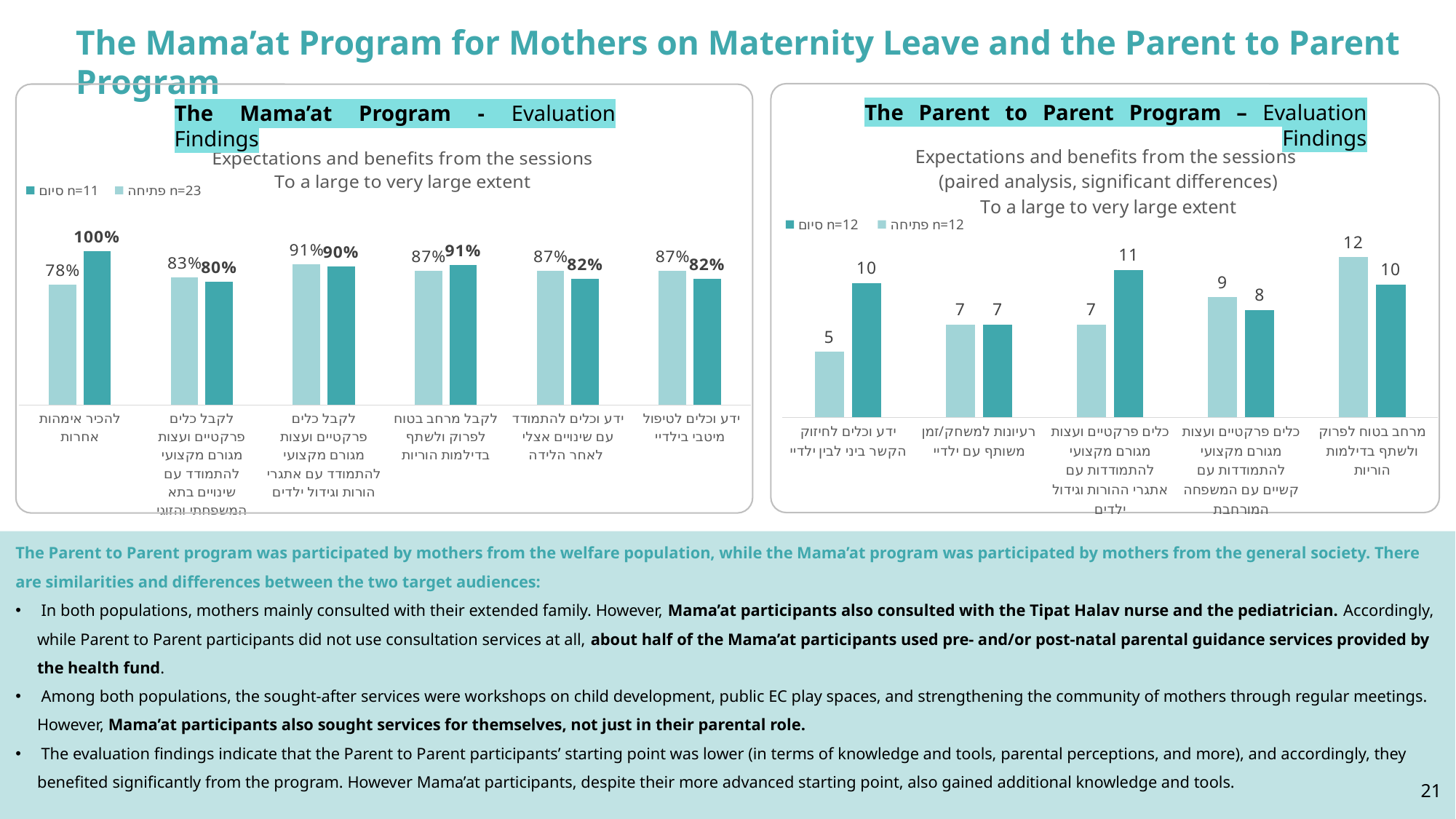
In the Parent to Parent Program chart on the right, which category has the highest opening (פתיחה) value? מרחב בטוח לפרוק ולשתף בדילמות הוריות In the Mama'at Program chart on the left, which series has the higher value for the fourth category, 'לקבל מרחב בטוח לפרוק ולשתף בדילמות הוריות'? סיום n=11 In the Parent to Parent Program chart on the right, what is the difference between the end (סיום) and opening (פתיחה) values for the first category, 'ידע וכלים לחיזוק הקשר ביני לבין ילדיי'? 5 What type of chart is the Parent to Parent Program chart on the right? Bar chart In the Mama'at Program chart on the left, what is the end-of-program (סיום) value for the first category, 'להכיר אימהות אחרות'? 100% In the Mama'at Program chart on the left, what is the difference between the end (סיום) and opening (פתיחה) values for the first category, 'להכיר אימהות אחרות'? 22% How many series does the legend list in the Parent to Parent Program chart on the right? 2 In the Mama'at Program chart on the left, what is the opening (פתיחה) value for the first category, 'להכיר אימהות אחרות'? 78% In the Parent to Parent Program chart on the right, what is the end (סיום) value for the third category, 'כלים פרקטיים ועצות מגורם מקצועי להתמודדות עם אתגרי ההורות וגידול ילדים'? 11 How many categories are shown in the Mama'at Program chart on the left? 6 In the Parent to Parent Program chart on the right, what is the opening (פתיחה) value for the first category, 'ידע וכלים לחיזוק הקשר ביני לבין ילדיי'? 5 In the Mama'at Program chart on the left, what is the opening (פתיחה) value for the second category, 'לקבל כלים פרקטיים ועצות מגורם מקצועי להתמודד עם שינויים בתא המשפחתי והזוגי'? 83%